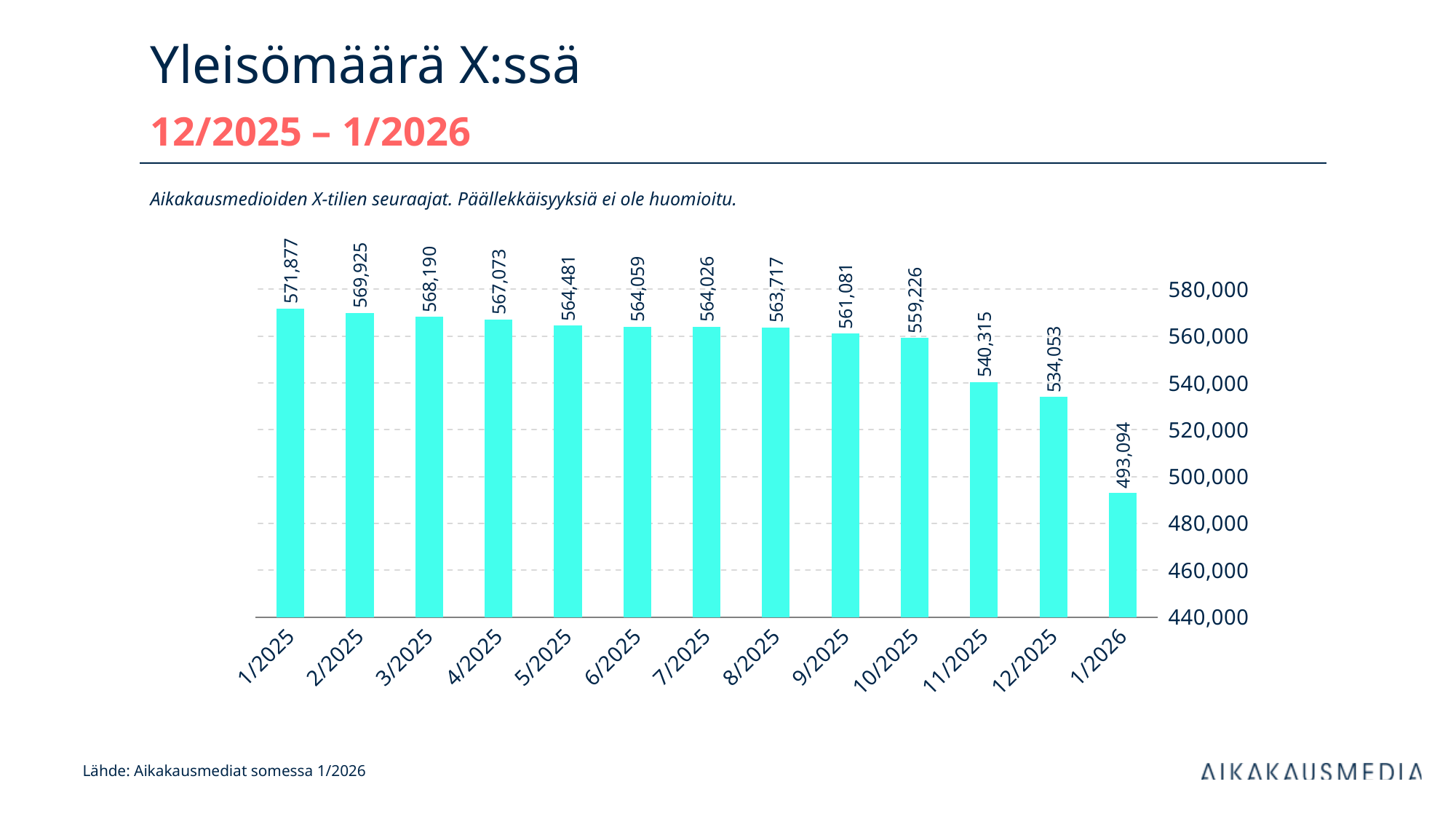
What is the value for 6/2025? 564,059 Which month has the highest value? 1/2025 What kind of chart is shown on the slide? bar chart What is the value for 12/2025? 534,053 What is the difference between the values for 1/2025 and 1/2026? 78,783 What is the value for 1/2026? 493,094 Which is larger, the value for 10/2025 or the value for 11/2025? 10/2025 How many months are shown on the x axis? 13 What is the difference between the values for 12/2025 and 1/2026? 40,959 Is the value for 1/2026 greater or less than 500,000? less Do the values rise or fall from 1/2025 to 1/2026? fall Which month has the lowest value? 1/2026